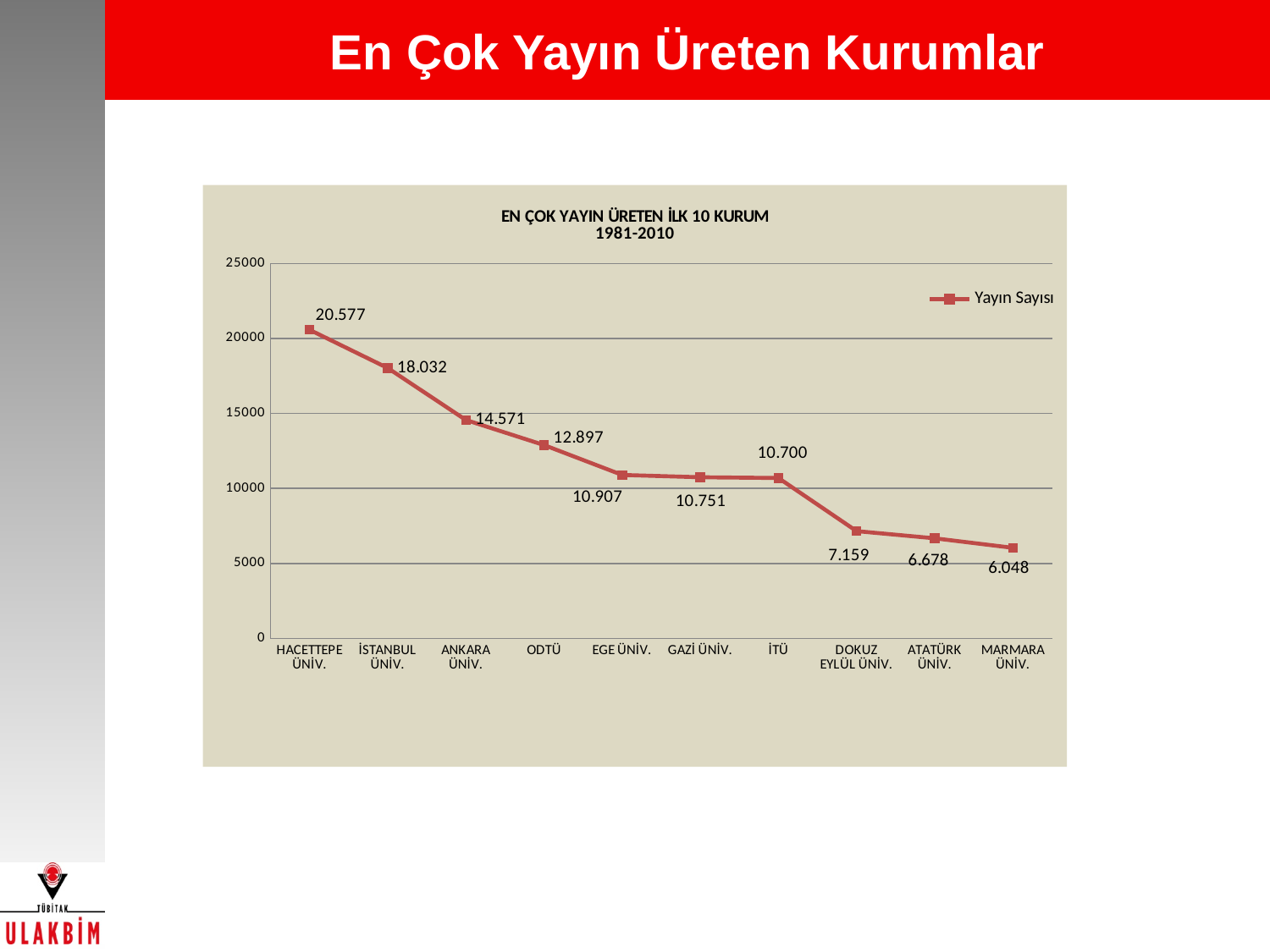
What is the difference between the values for HACETTEPE ÜNİV. and İSTANBUL ÜNİV.? 2.545 Do the values rise or fall from left to right along the x axis? Fall Which has a larger value, ANKARA ÜNİV. or DOKUZ EYLÜL ÜNİV.? ANKARA ÜNİV. Which institution has the lowest number of publications? MARMARA ÜNİV. What is the value for ODTÜ? 12.897 What is the value for HACETTEPE ÜNİV.? 20.577 What type of chart is shown on the slide? Line chart What is the name of the series shown in the legend? Yayın Sayısı What is the value for İTÜ? 10.700 What is the value for MARMARA ÜNİV.? 6.048 How many institutions are plotted on the chart? 10 Which institution has the highest number of publications? HACETTEPE ÜNİV.